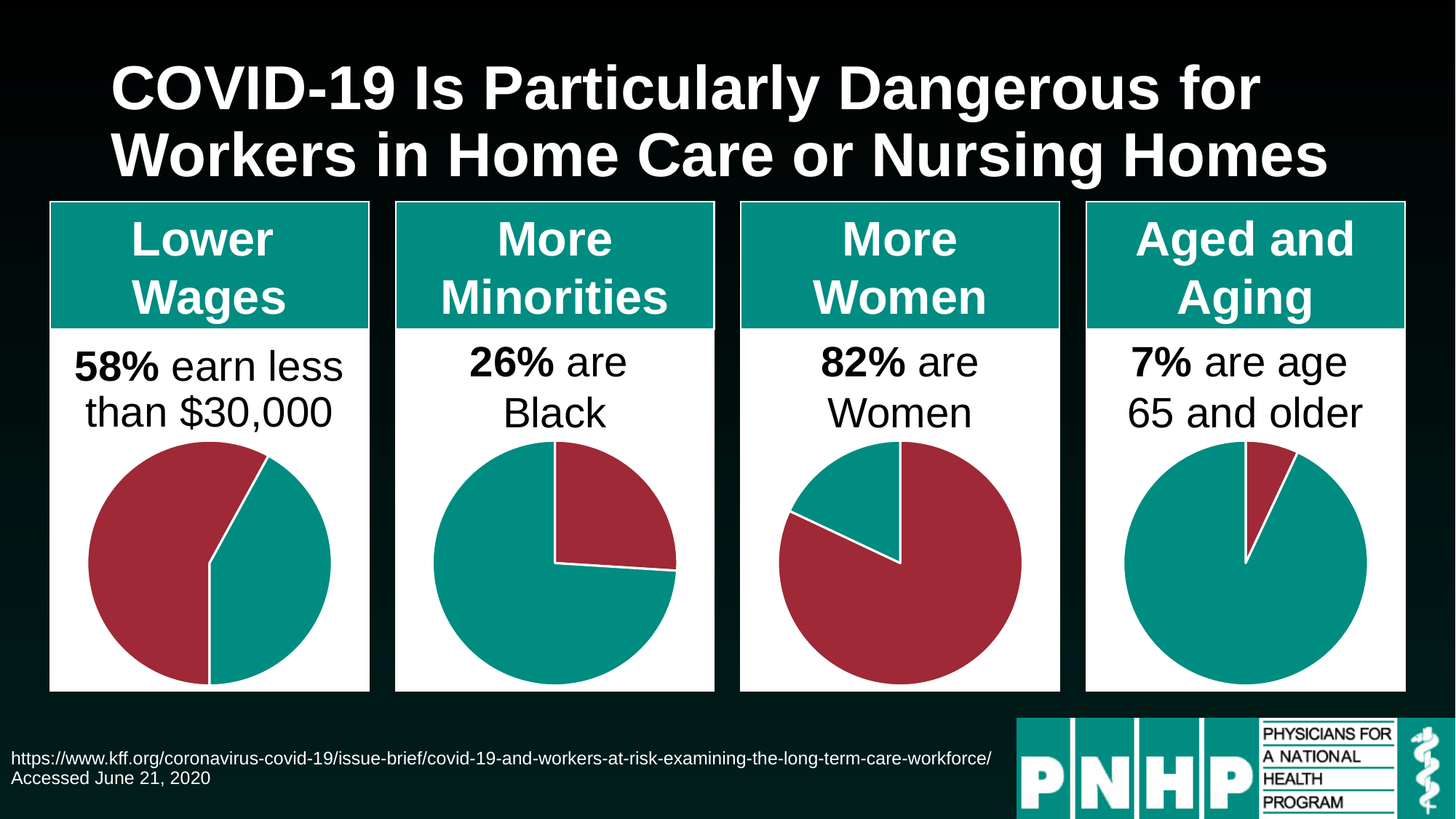
Which of the four charts shows the smallest highlighted share? Aged and Aging In the "Lower Wages" chart, what percentage of workers earn less than $30,000? 58% Which of the four charts shows the largest highlighted share? More Women What kind of chart is used in each of the four panels on the slide? Pie chart What is the difference between the percentage of workers who are women ("More Women" chart) and the percentage who are Black ("More Minorities" chart)? 56% Which is larger: the share of workers who are women ("More Women" chart) or the share who earn less than $30,000 ("Lower Wages" chart)? The share who are women How many pie charts are shown on the slide? 4 In the "Lower Wages" chart, what share of the pie is the red slice? 58% In the "Aged and Aging" chart, what percentage of workers are age 65 and older? 7% In the "More Women" chart, what percentage of workers are women? 82% What colour is the slice representing the highlighted percentage in each pie chart? Red In the "More Minorities" chart, what percentage of workers are Black? 26%